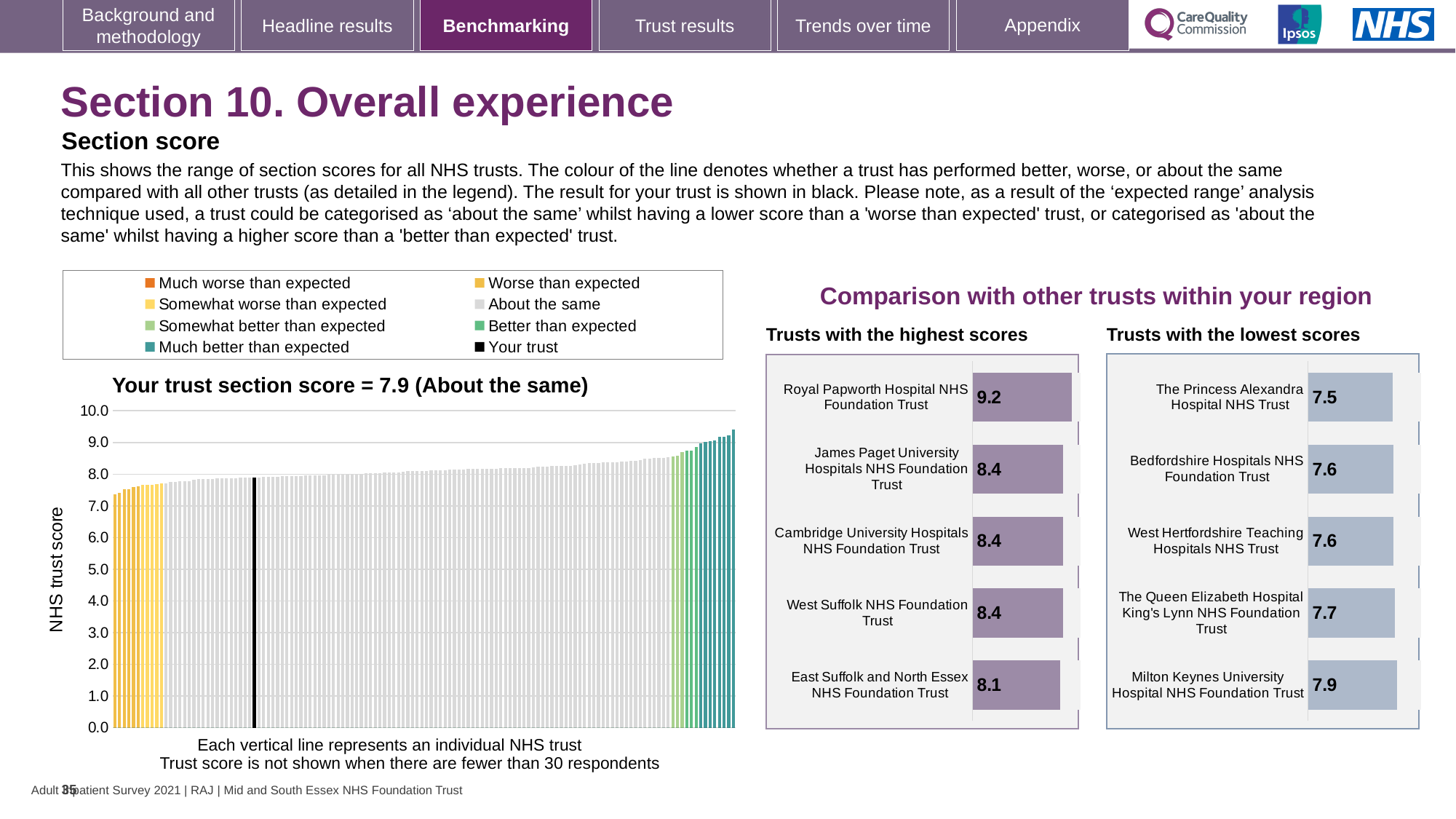
In the 'Your trust section score' chart, what is the section score for your trust? 7.9 In the 'Trusts with the highest scores' chart, which trust has the highest score? Royal Papworth Hospital NHS Foundation Trust In the 'Your trust section score' chart, how many entries does the legend list? 8 In the 'Your trust section score' chart, is the value of the leftmost bar greater or less than 7.0? greater In the 'Trusts with the lowest scores' chart, how many trusts are shown? 5 In the 'Your trust section score' chart, what is the label on the vertical axis? NHS trust score In the 'Trusts with the lowest scores' chart, which trust has the lowest score? The Princess Alexandra Hospital NHS Trust In the 'Trusts with the highest scores' chart, what is the difference between the scores of Royal Papworth Hospital NHS Foundation Trust and East Suffolk and North Essex NHS Foundation Trust? 1.1 In the 'Your trust section score' chart, do the bar values rise or fall from left to right? rise In the 'Your trust section score' chart, what kind of chart is shown? bar chart In the 'Trusts with the highest scores' chart, what is the score for East Suffolk and North Essex NHS Foundation Trust? 8.1 In the 'Trusts with the lowest scores' chart, what is the score for The Queen Elizabeth Hospital King's Lynn NHS Foundation Trust? 7.7